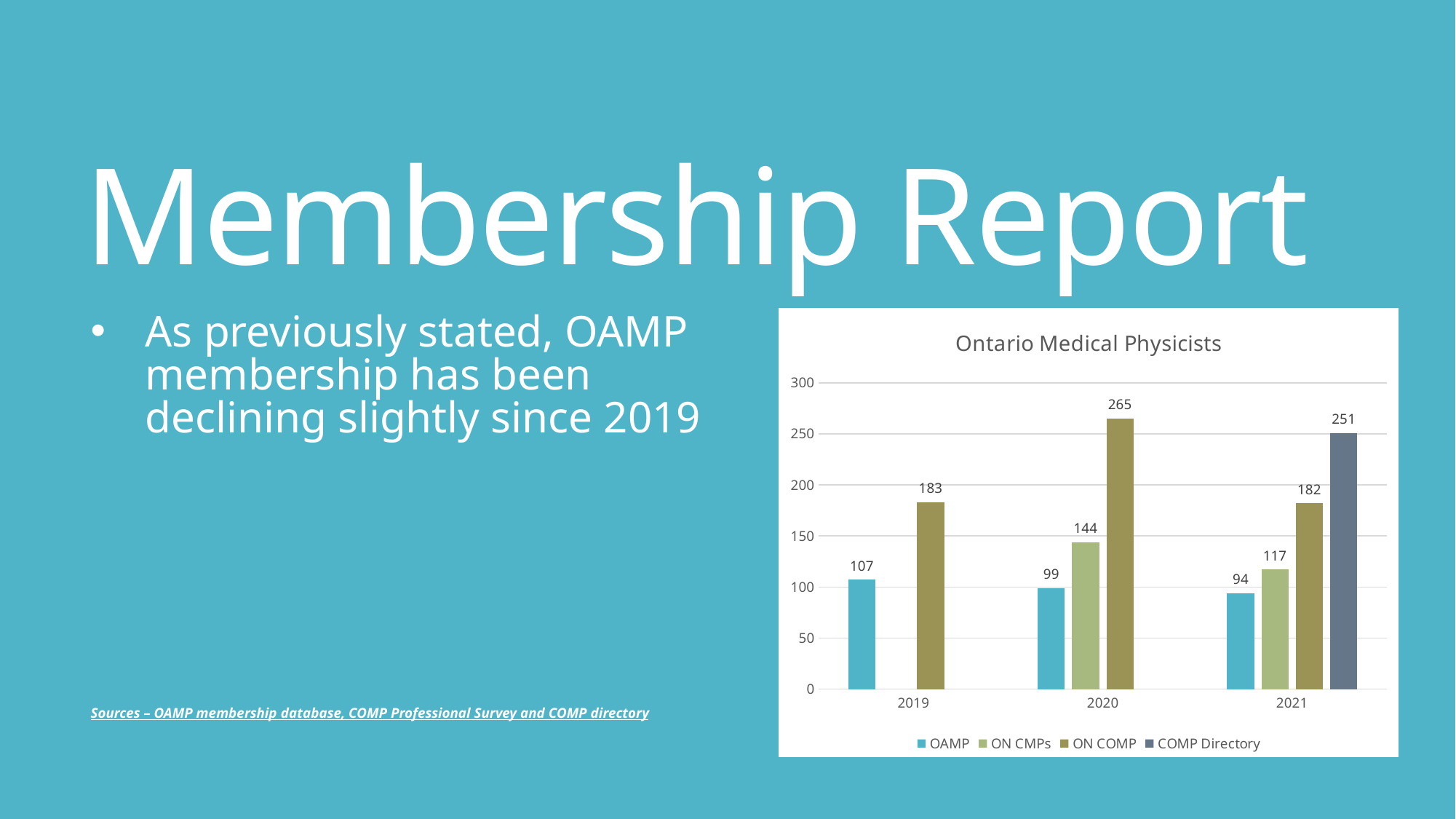
What is the difference between the ON COMP values for 2020 and 2021? 83 Which is larger in 2020, ON CMPs or OAMP? ON CMPs What is the OAMP value for 2019? 107 What is the ON CMPs value for 2021? 117 What kind of chart is shown? Bar chart How many series does the legend list? 4 Does the OAMP value rise or fall from 2019 to 2021? Fall What is the ON COMP value for 2020? 265 In which year is the ON COMP value highest? 2020 What is the COMP Directory value for 2021? 251 How many years are shown on the x axis? 3 In which year is the OAMP value lowest? 2021